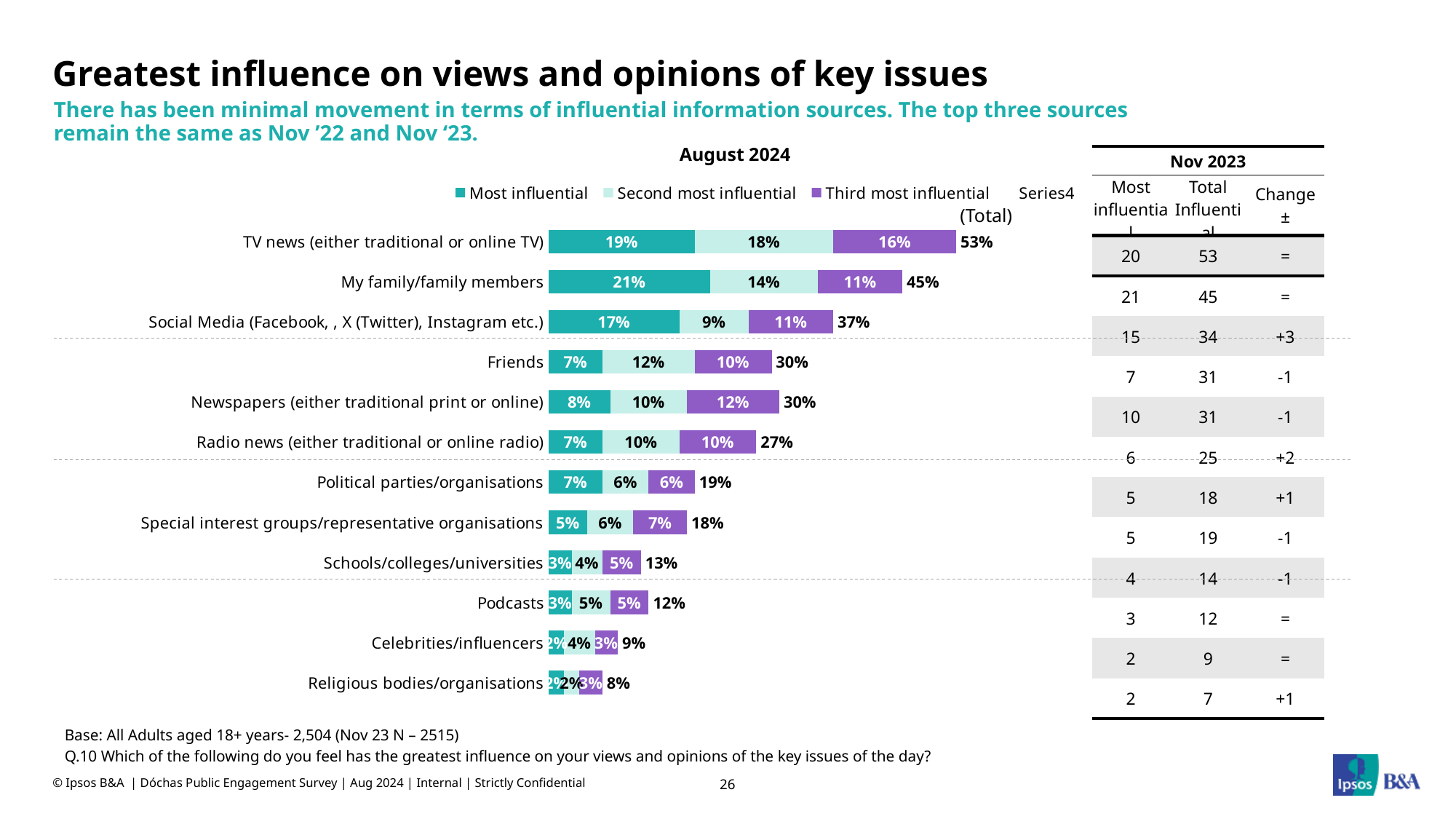
How many categories (information sources) are plotted in the chart? 12 What is the 'Third most influential' value for Newspapers (either traditional print or online)? 12% What type of chart is shown on the slide? Stacked bar chart What is the total value shown for Social Media (Facebook, X (Twitter), Instagram etc.)? 37% How many entries does the chart legend list? 4 What is the 'Second most influential' value for Friends? 12% Which is larger: the 'Most influential' value for Newspapers (either traditional print or online) or for Radio news (either traditional or online radio)? Newspapers (either traditional print or online) What is the 'Most influential' value for TV news (either traditional or online TV)? 19% Which category has the highest 'Most influential' value? My family/family members Which category has the lowest total value? Religious bodies/organisations What period does the chart title refer to? August 2024 What is the difference between the total for TV news (either traditional or online TV) and the total for My family/family members? 8%